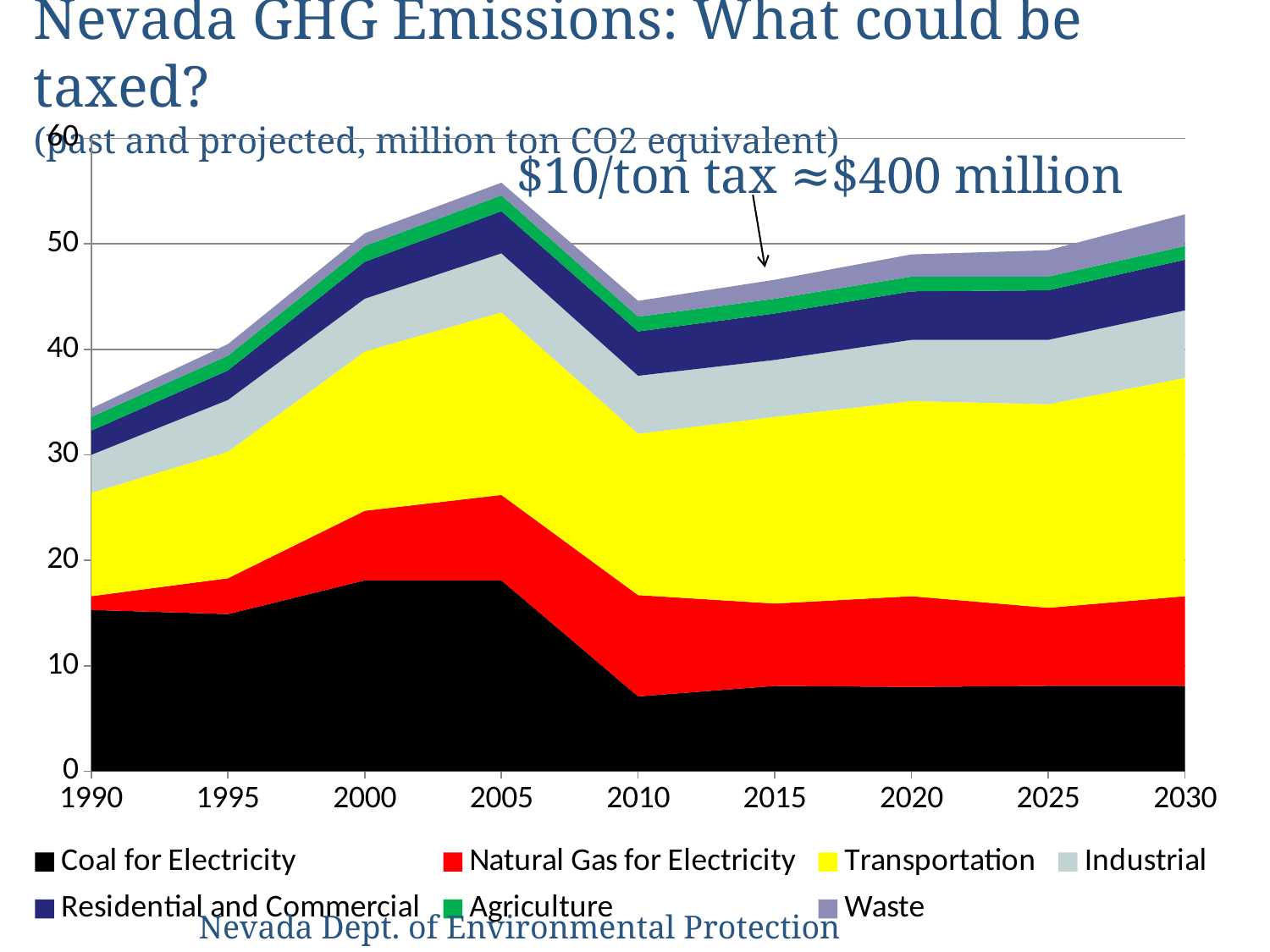
How many series does the legend list? 7 How many years are plotted along the x axis? 9 Is the total emissions value for 2005 greater or less than 50? greater Which is larger, the Coal for Electricity value in 1990 or in 2030? 1990 Which year has the highest total emissions? 2005 Which series is shown in yellow? Transportation Which year has the lowest total emissions? 1990 What kind of chart is shown on the slide? stacked area chart Is the Coal for Electricity value in 2010 greater or less than 10? less Does the Coal for Electricity value rise or fall between 2005 and 2010? fall Is the total emissions value for 2010 greater or less than 50? less